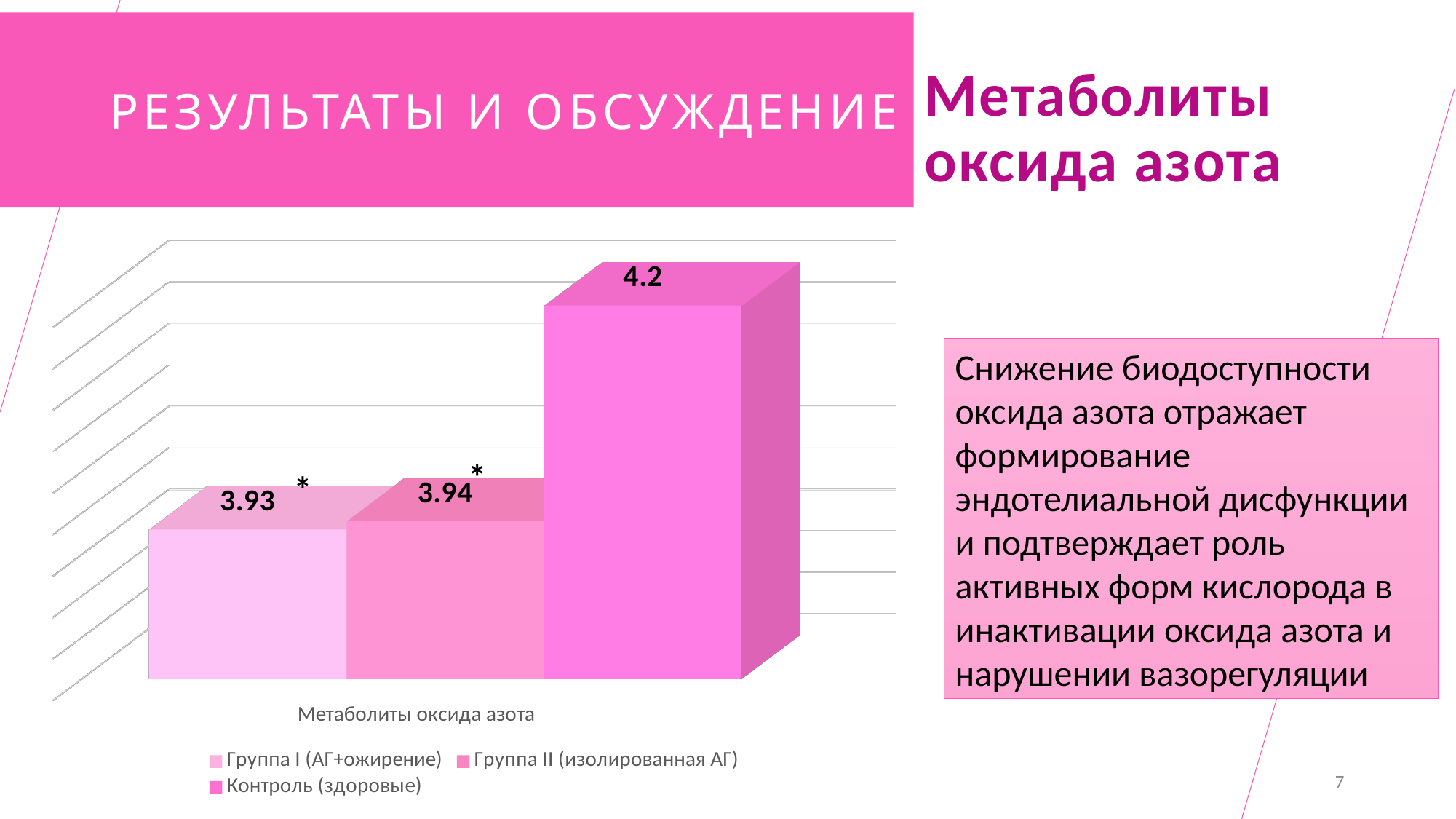
What is the category label shown on the x axis of the chart? Метаболиты оксида азота What is the difference between the value for Контроль (здоровые) and the value for Группа II (изолированная АГ)? 0.26 What is the value for Группа I (АГ+ожирение) in the chart? 3.93 Which legend entry is listed first in the chart's legend? Группа I (АГ+ожирение) Which series has the highest value in the chart? Контроль (здоровые) What is the difference between the value for Контроль (здоровые) and the value for Группа I (АГ+ожирение)? 0.27 How many categories are shown on the x axis of the chart? 1 What is the value for Контроль (здоровые) in the chart? 4.2 Which is larger: the value for Контроль (здоровые) or the value for Группа I (АГ+ожирение)? Контроль (здоровые) How many series does the legend of the chart list? 3 What is the value for Группа II (изолированная АГ) in the chart? 3.94 What kind of chart is shown on the slide? bar chart